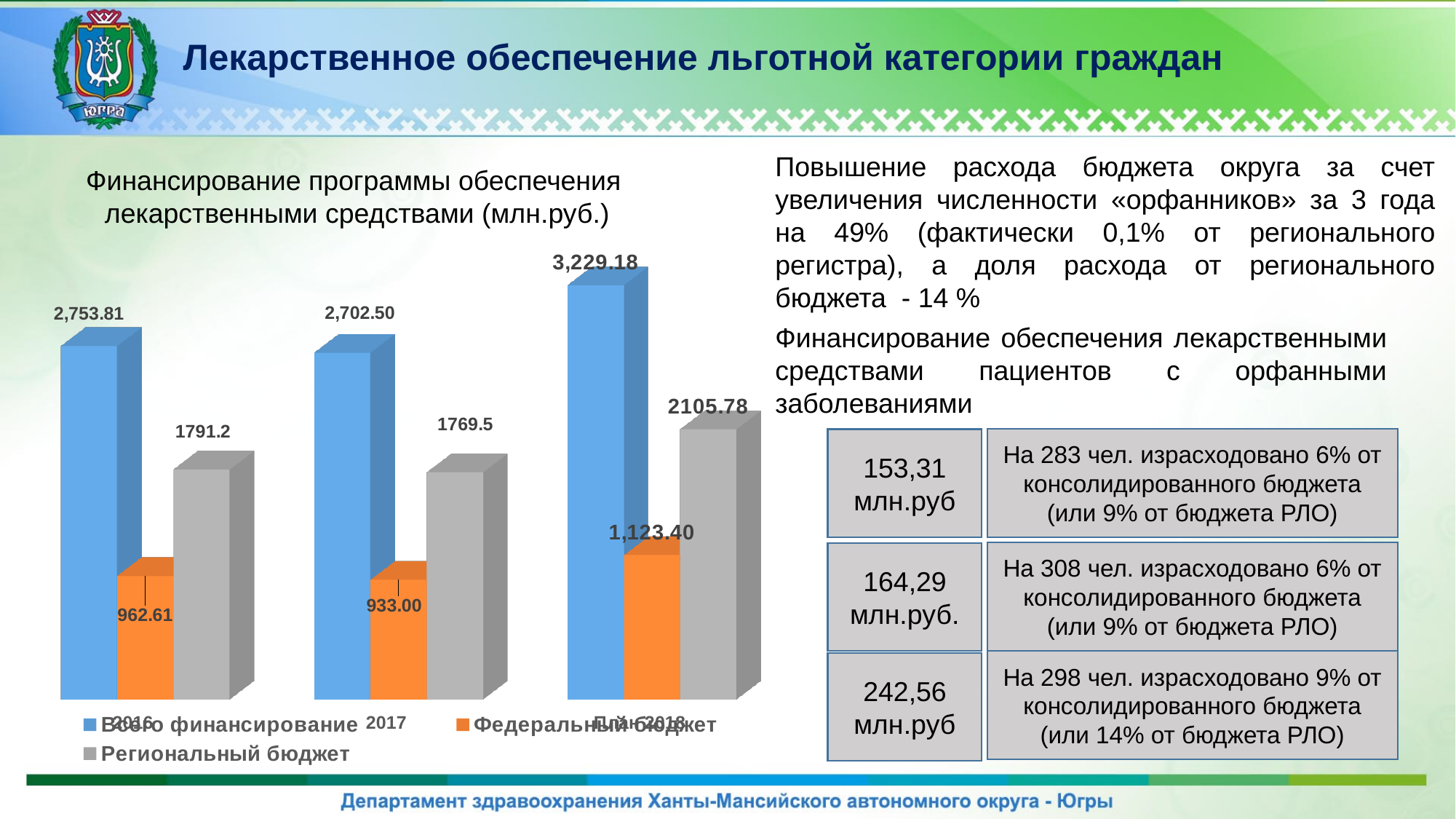
What is the value of Федеральный бюджет for 2016? 962.61 Which category has the highest value for Всего финансирование? План 2018 What is the title of the chart? Финансирование программы обеспечения лекарственными средствами (млн.руб.) What kind of chart is shown on the slide? Bar chart How many categories (years) are shown on the x axis of the chart? 3 What is the value of Всего финансирование for 2017? 2,702.50 Which category has the lowest value for Федеральный бюджет? 2017 What is the difference between Всего финансирование in 2016 and in 2017? 51.31 Does the value of Федеральный бюджет rise or fall from 2016 to 2017? Fall Which is larger: Региональный бюджет in 2016 or in 2017? 2016 What is the value of Региональный бюджет for План 2018? 2105.78 How many series does the chart legend list? 3